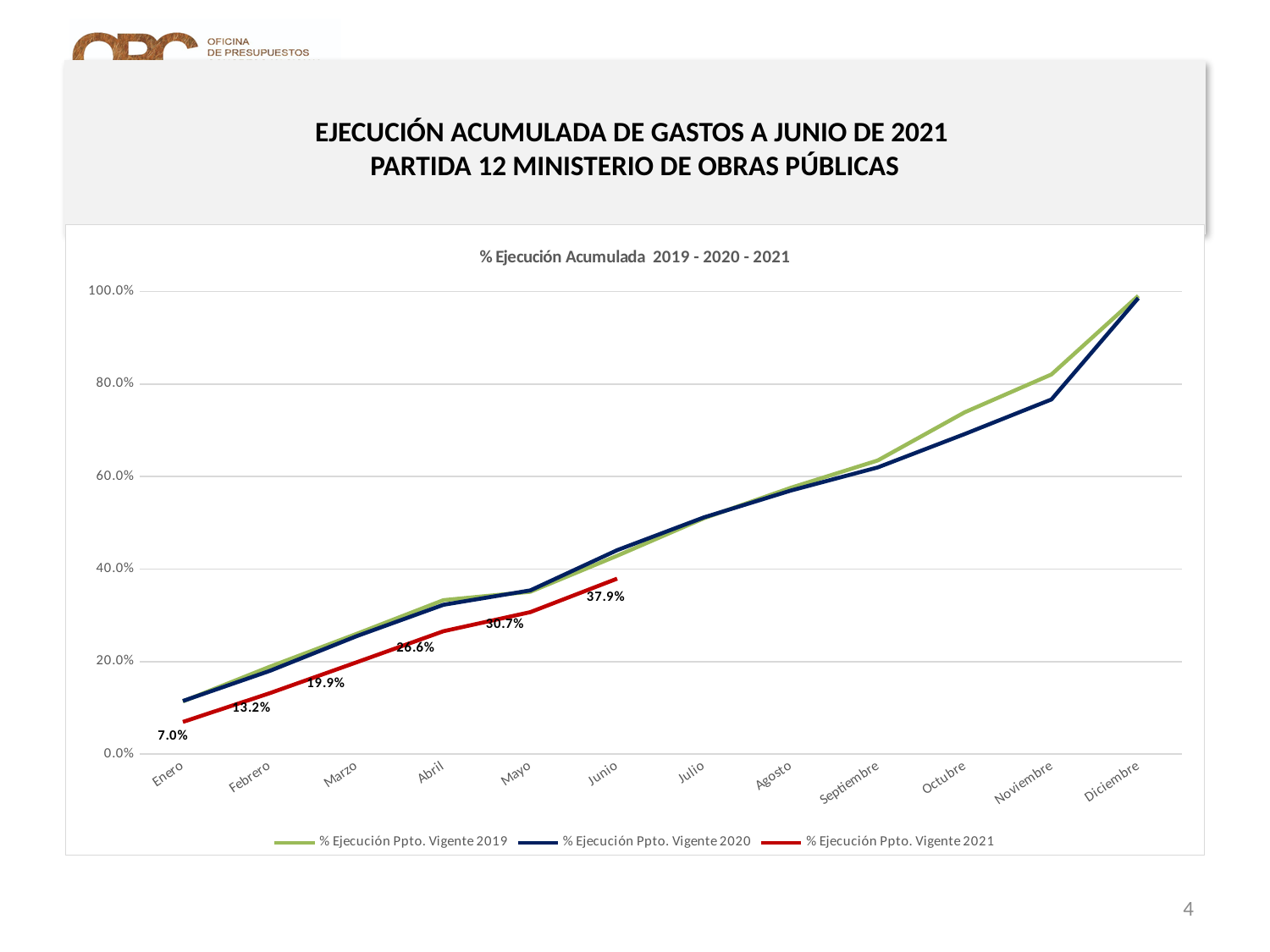
Which month has the highest value for % Ejecución Ppto. Vigente 2021? Junio Does the % Ejecución Ppto. Vigente 2021 series rise or fall from Enero to Junio? rise What type of chart is shown on the slide? line chart What is the value of % Ejecución Ppto. Vigente 2021 for Junio? 37.9% How many series does the legend list? 3 What is the difference between the 2021 values for Mayo and Abril? 4.1% Is the value for % Ejecución Ppto. Vigente 2019 in Diciembre greater or less than 80.0%? greater What is the title of the chart? % Ejecución Acumulada 2019 - 2020 - 2021 What is the difference between the 2021 values for Junio and Enero? 30.9% What is the value of % Ejecución Ppto. Vigente 2021 for Enero? 7.0% How many months are shown on the x axis? 12 What is the value of % Ejecución Ppto. Vigente 2021 for Abril? 26.6%